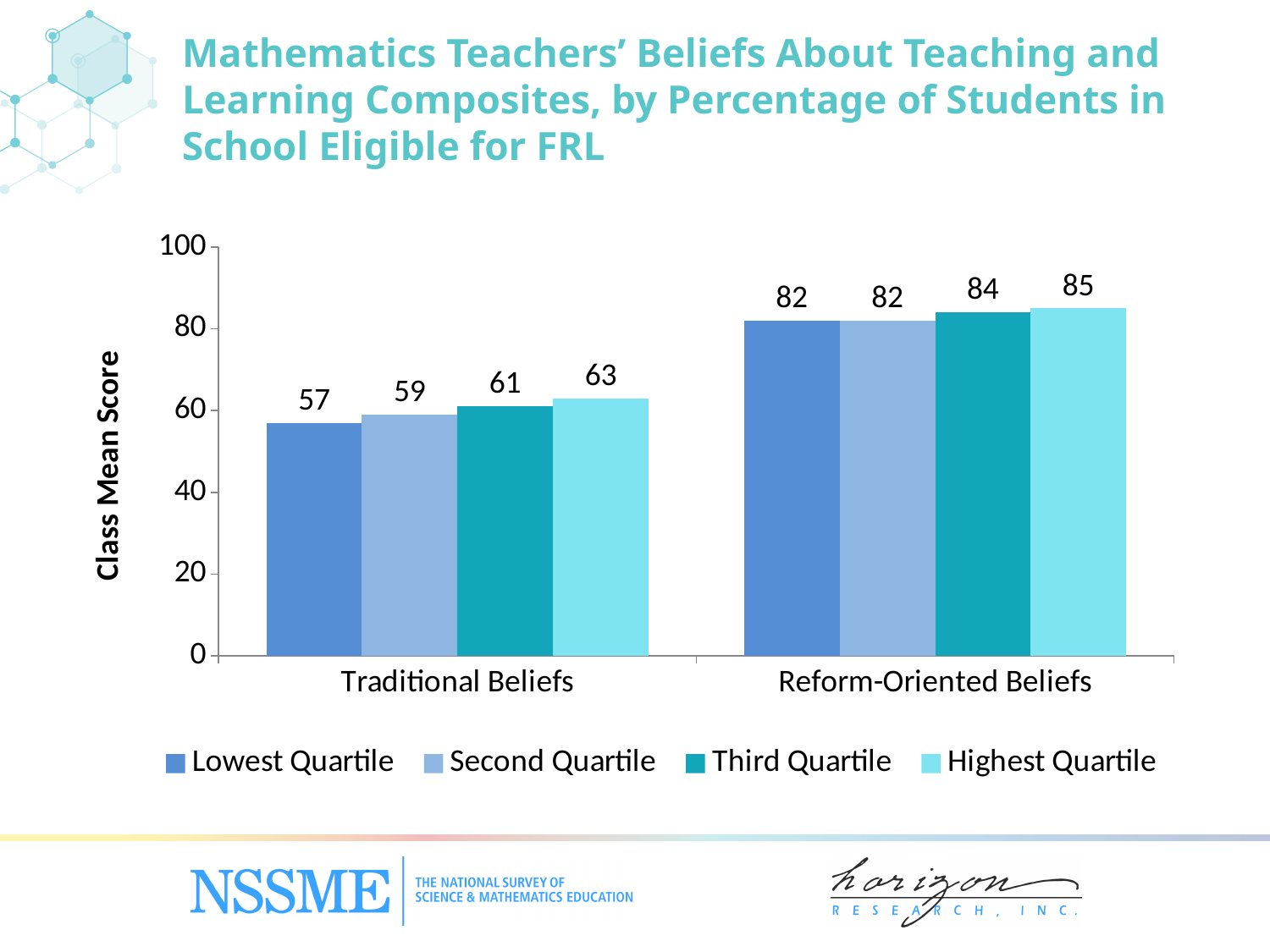
What is the class mean score for the Highest Quartile on Reform-Oriented Beliefs? 85 How many series does the legend list? 4 Which is larger for the Highest Quartile: the Traditional Beliefs score or the Reform-Oriented Beliefs score? Reform-Oriented Beliefs Which quartile has the lowest class mean score for Reform-Oriented Beliefs? Lowest Quartile and Second Quartile (tied at 82) What is the difference between the Reform-Oriented Beliefs and Traditional Beliefs scores for the Third Quartile? 23 What kind of chart is shown on the slide? Bar chart What is the difference between the Highest Quartile and Lowest Quartile scores for Traditional Beliefs? 6 What is the label of the vertical axis? Class Mean Score What is the class mean score for the Second Quartile on Reform-Oriented Beliefs? 82 Which quartile has the highest class mean score for Traditional Beliefs? Highest Quartile What is the class mean score for the Third Quartile on Traditional Beliefs? 61 What is the class mean score for the Lowest Quartile on Traditional Beliefs? 57